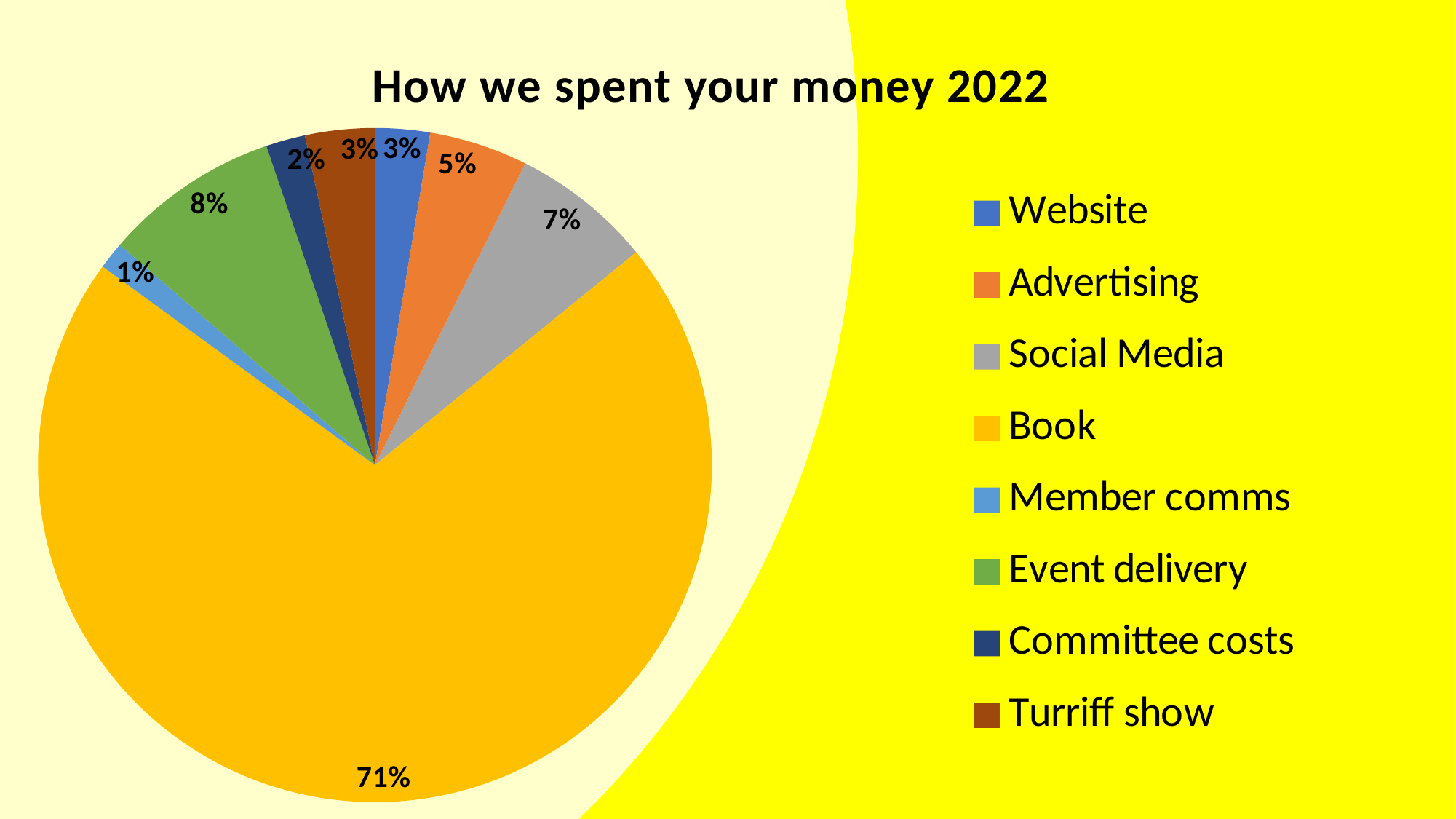
What is the difference between the share for Event delivery and the share for Committee costs? 6% Which is larger, the share for Advertising or the share for Social Media? Social Media What share of spending went to Member comms? 1% What is the title of the chart? How we spent your money 2022 What share of spending went to Social Media? 7% What share of spending went to Book? 71% What colour is the slice for Turriff show? brown Which category has the largest share of spending? Book Which category has the smallest share of spending? Member comms How many categories does the legend list? 8 What kind of chart is shown on the slide? pie chart